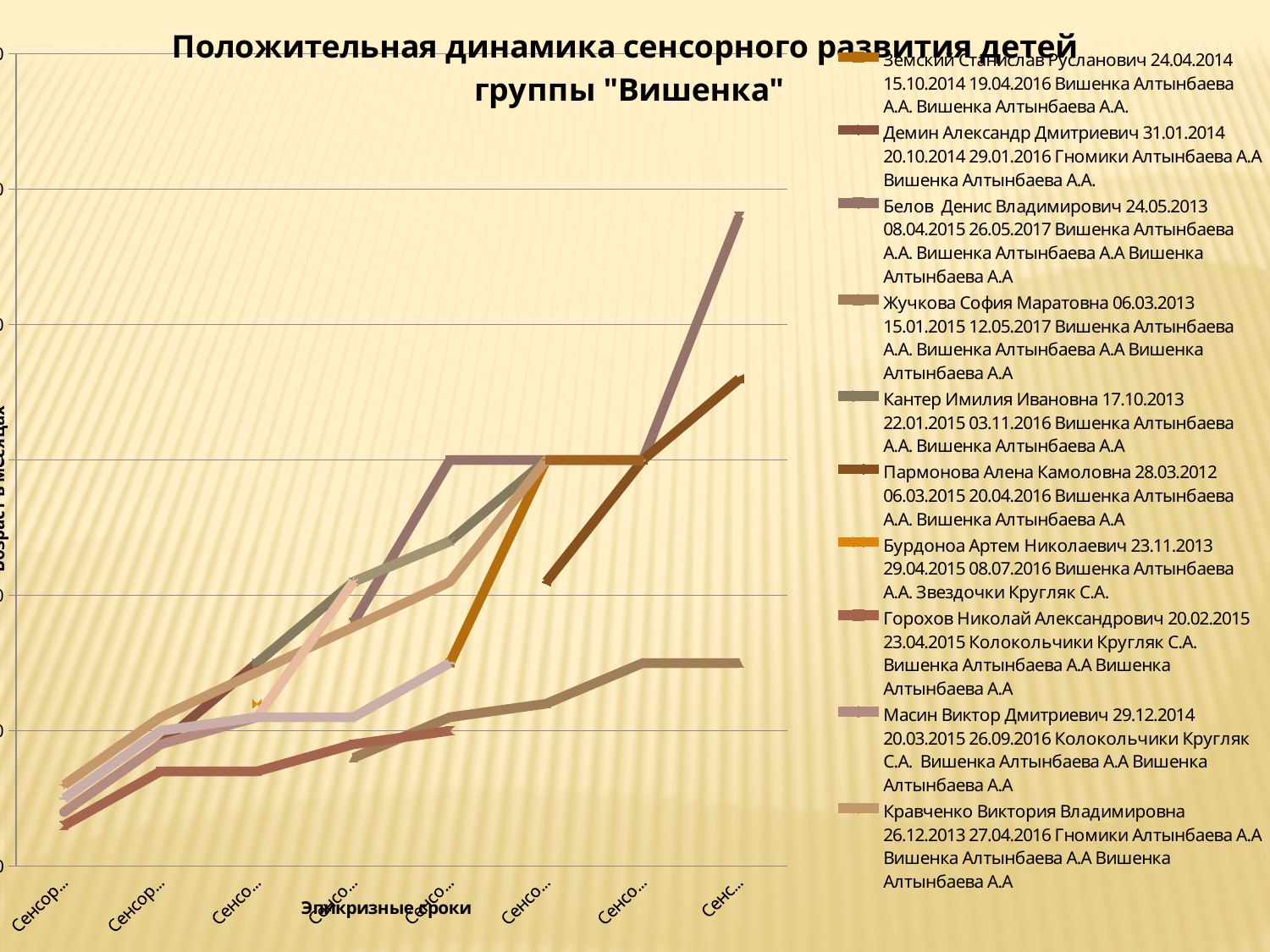
What is the title of the x axis? Эпикризные сроки How many series does the legend list? 10 Which series reaches the highest value at the right end of the chart? Белов Денис Владимирович What kind of chart is shown on the slide? line chart Do the plotted lines generally rise or fall from left to right along the x axis? rise What is the title of the chart? Положительная динамика сенсорного развития детей группы "Вишенка" How many categories are marked along the x axis? 8